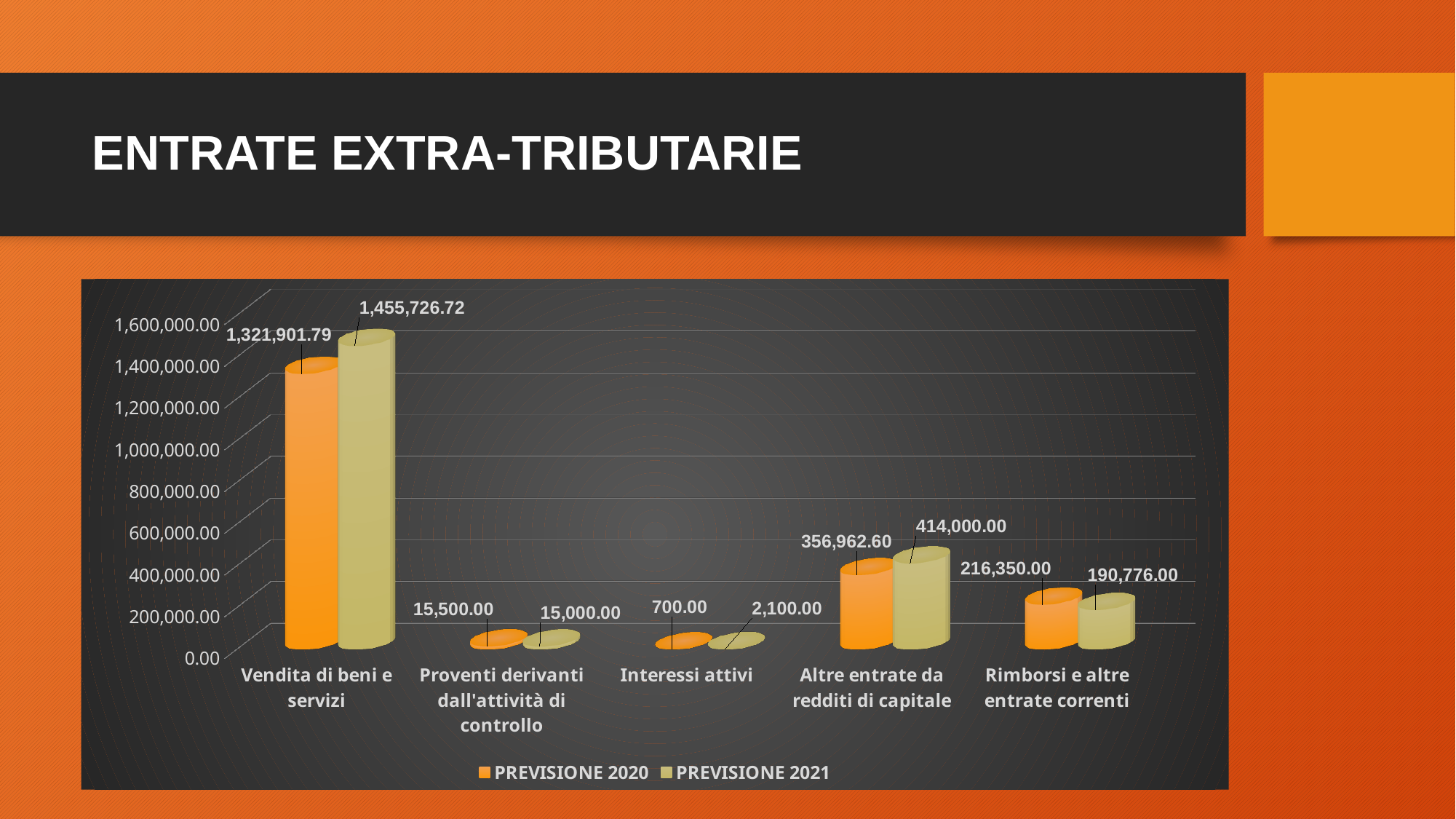
What kind of chart is shown on the slide? Bar chart What is the PREVISIONE 2020 value for Rimborsi e altre entrate correnti? 216,350.00 What is the difference between the PREVISIONE 2020 and PREVISIONE 2021 values for Rimborsi e altre entrate correnti? 25,574.00 Which category has the highest PREVISIONE 2021 value? Vendita di beni e servizi Which category has the lowest PREVISIONE 2020 value? Interessi attivi How many series does the legend list? 2 What is the PREVISIONE 2021 value for Interessi attivi? 2,100.00 For Altre entrate da redditi di capitale, which is larger: PREVISIONE 2020 or PREVISIONE 2021? PREVISIONE 2021 What is the PREVISIONE 2020 value for Vendita di beni e servizi? 1,321,901.79 How many categories are shown on the x axis? 5 What is the difference between the PREVISIONE 2021 and PREVISIONE 2020 values for Vendita di beni e servizi? 133,824.93 What is the PREVISIONE 2021 value for Altre entrate da redditi di capitale? 414,000.00